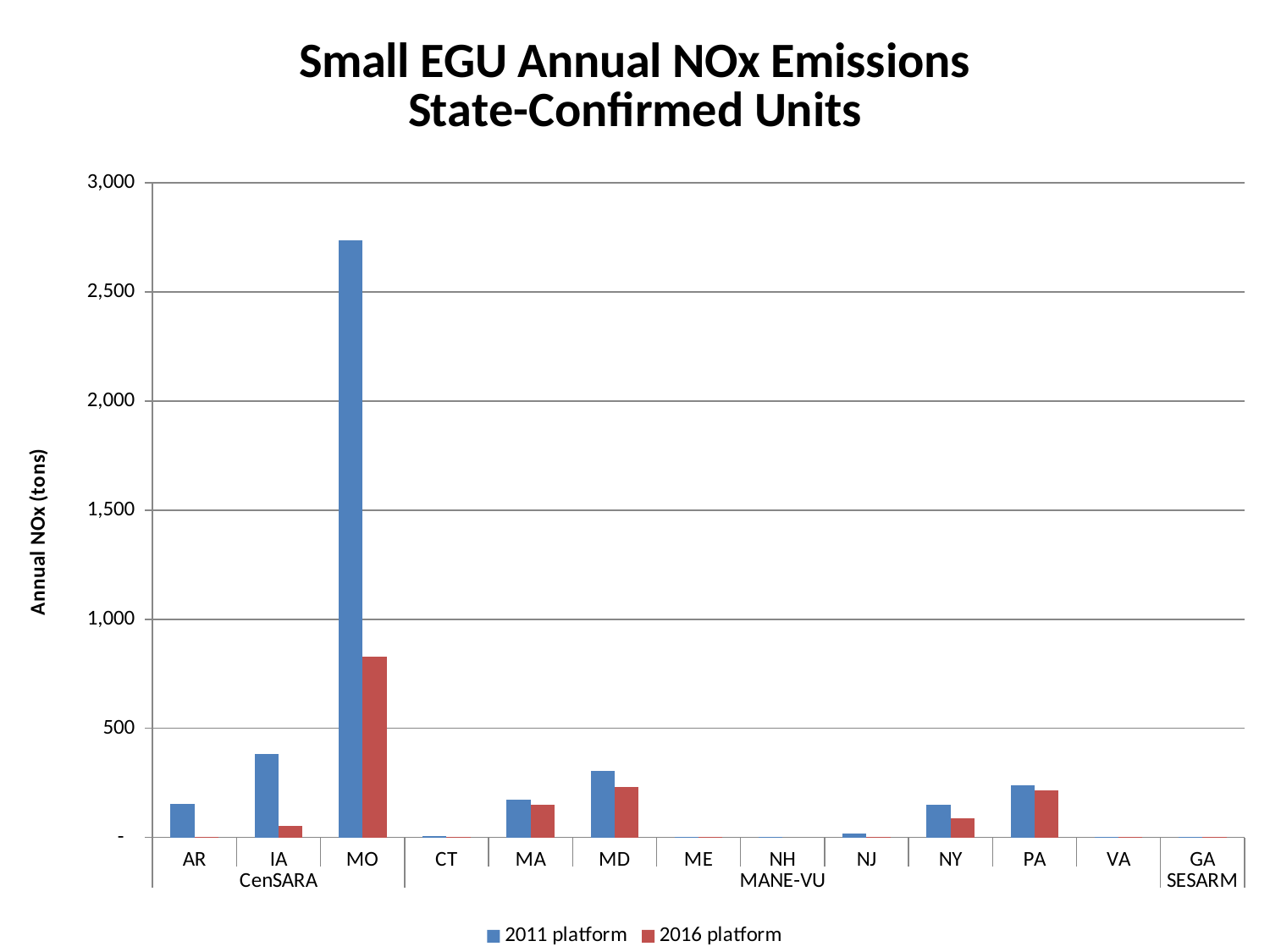
Is the 2016 platform value for MO greater or less than 1,000? less For MO, which is larger: the 2011 platform value or the 2016 platform value? 2011 platform How many states are shown along the x axis? 13 Is the 2011 platform value for IA greater or less than 500? less Which state has the highest 2016 platform NOx emissions? MO What kind of chart is shown on the slide? bar chart How many series does the legend list? 2 Is the 2016 platform value for MO greater or less than 500? greater What is the label on the vertical axis? Annual NOx (tons) Which state has the highest 2011 platform NOx emissions? MO For NY, which is larger: the 2011 platform value or the 2016 platform value? 2011 platform